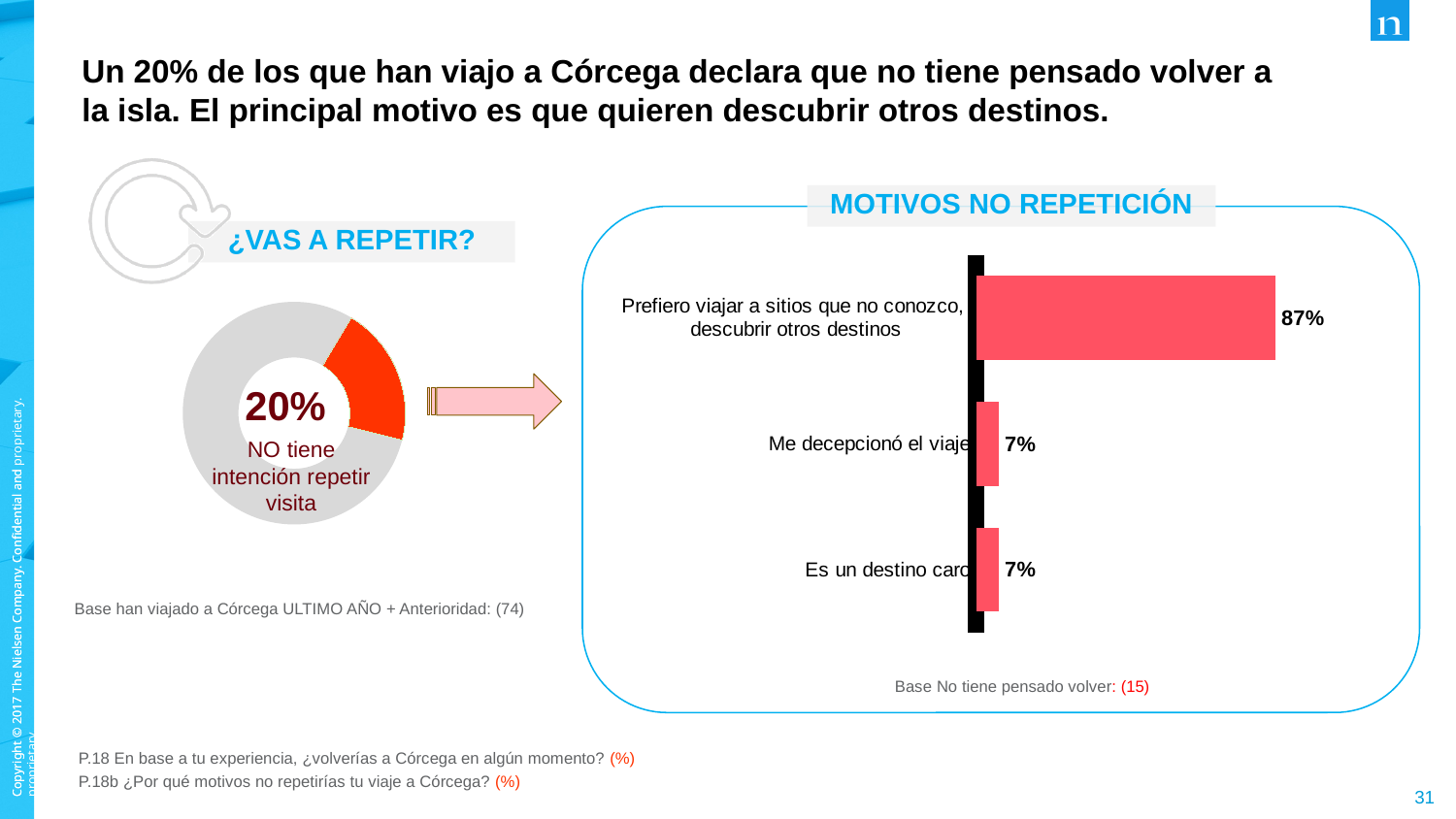
In the 'MOTIVOS NO REPETICIÓN' chart, what is the difference between 'Prefiero viajar a sitios que no conozco, descubrir otros destinos' and 'Me decepcionó el viaje'? 80% In the 'MOTIVOS NO REPETICIÓN' chart, what is the value for 'Prefiero viajar a sitios que no conozco, descubrir otros destinos'? 87% What kind of chart is the 'MOTIVOS NO REPETICIÓN' chart? Bar chart In the 'MOTIVOS NO REPETICIÓN' chart, what is the value for 'Me decepcionó el viaje'? 7% In the 'MOTIVOS NO REPETICIÓN' chart, which is larger: 'Prefiero viajar a sitios que no conozco, descubrir otros destinos' or 'Es un destino caro'? Prefiero viajar a sitios que no conozco, descubrir otros destinos What is the title of the bar chart on the right of the slide? MOTIVOS NO REPETICIÓN What is the base size shown for the 'MOTIVOS NO REPETICIÓN' chart? 15 In the 'MOTIVOS NO REPETICIÓN' chart, what is the value for 'Es un destino caro'? 7% How many categories are shown in the 'MOTIVOS NO REPETICIÓN' chart? 3 What kind of chart is shown under '¿VAS A REPETIR?' on the left of the slide? Donut chart In the 'MOTIVOS NO REPETICIÓN' chart, which category has the highest value? Prefiero viajar a sitios que no conozco, descubrir otros destinos In the '¿VAS A REPETIR?' donut chart, what percentage has no intention of repeating the visit? 20%